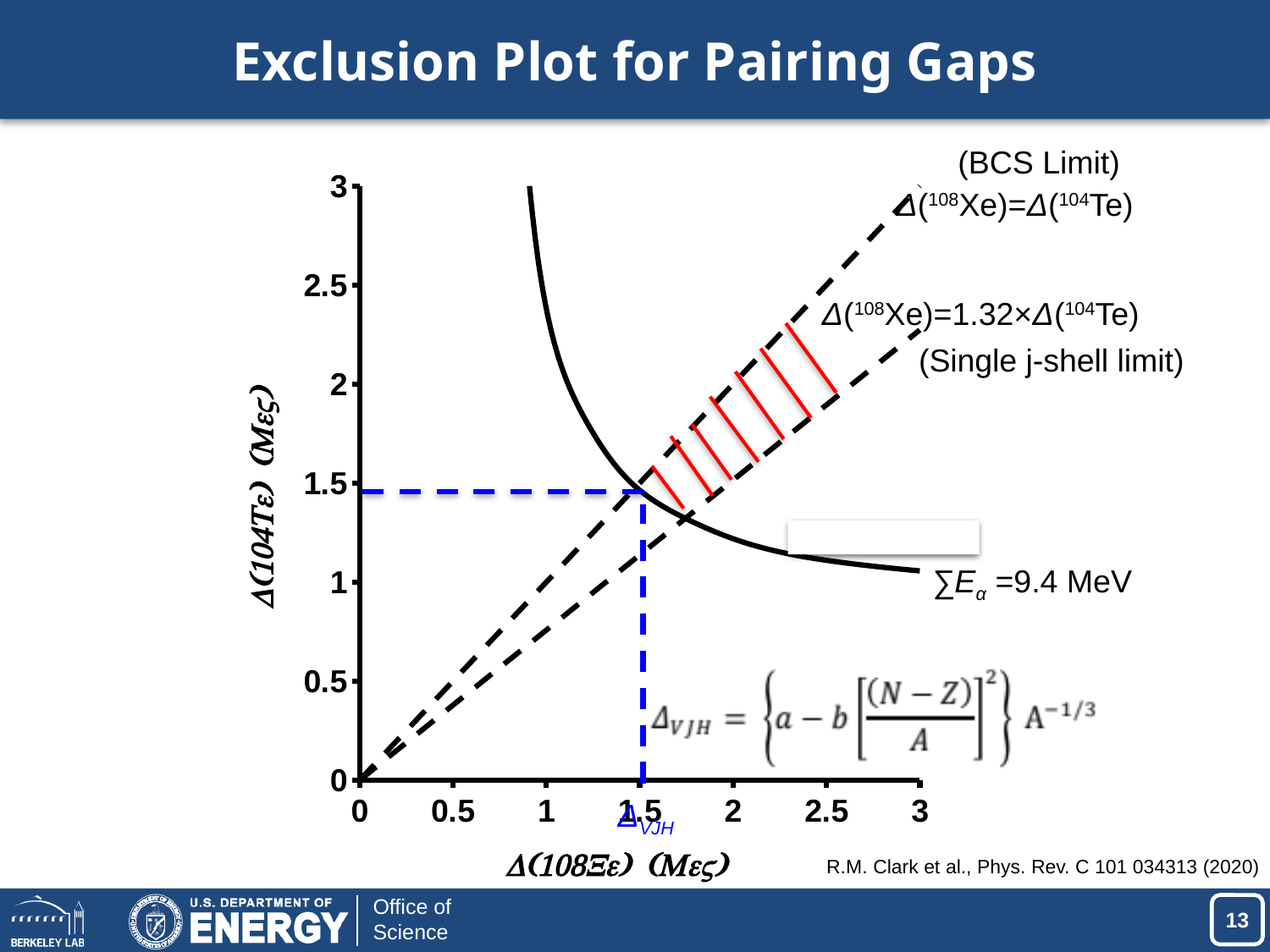
Do the two dashed limit lines rise or fall as Δ(108Xe) increases? rise Which relation is labelled as the BCS Limit? Δ(108Xe)=Δ(104Te) Is the Δ_VJH value marked on the x axis greater or less than 2? less Does the solid ∑Eα curve rise or fall as Δ(108Xe) increases? fall What kind of chart is shown on the slide? line chart What is the label on the x axis of the chart? Δ(108Xe) (MeV) What is the label on the y axis of the chart? Δ(104Te) (MeV) What is the title of the chart on the slide? Exclusion Plot for Pairing Gaps What multiplying factor appears in the Single j-shell limit relation? 1.32 What colour is the hatching in the region between the two dashed lines? red What is the maximum value shown on the x axis? 3 What value of ∑Eα labels the solid curve? 9.4 MeV